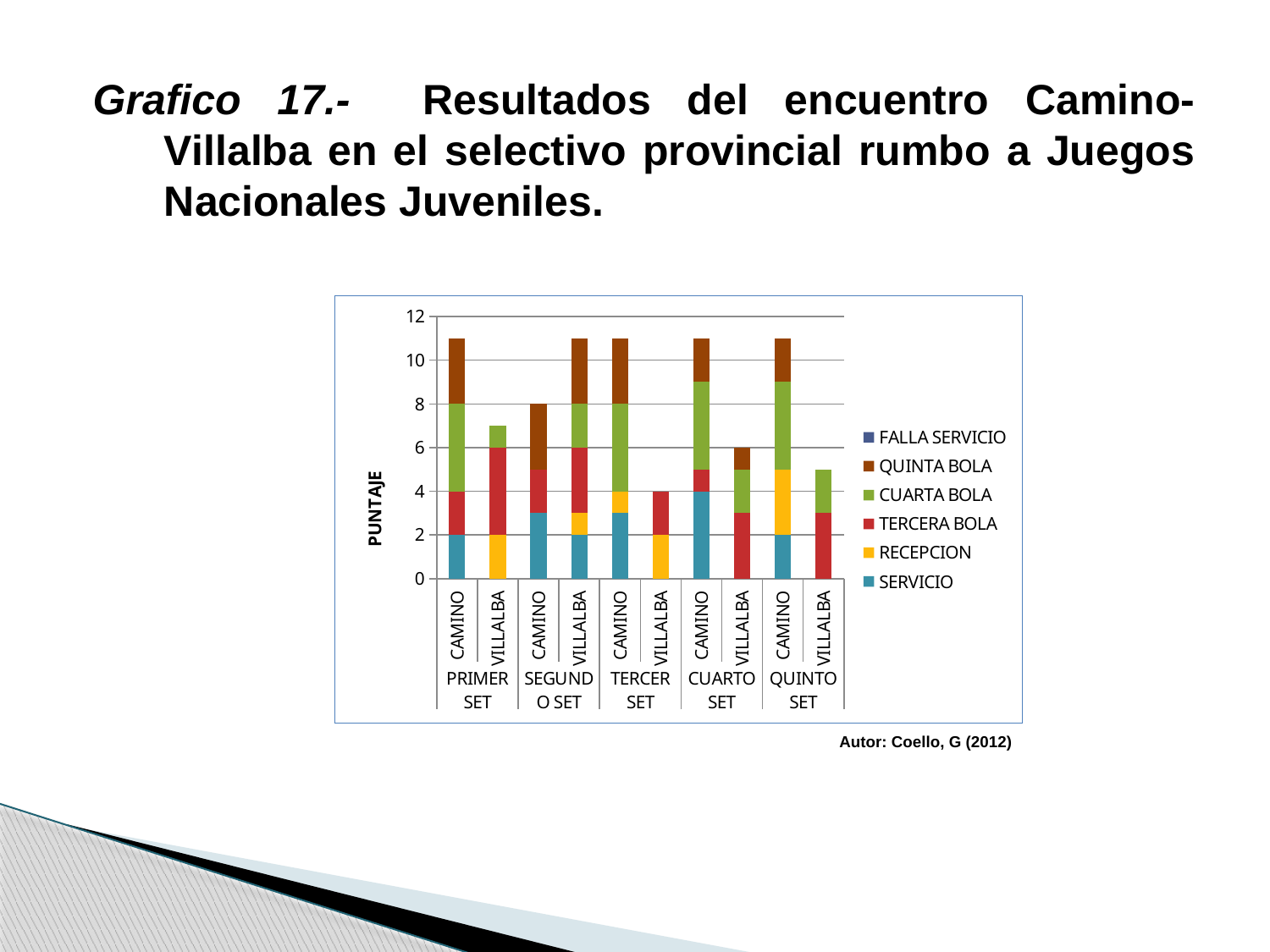
Which bar has the lowest total score in the chart? VILLALBA, TERCER SET Is the total for CAMINO in PRIMER SET greater or less than 10? greater What kind of chart is shown on the slide? Stacked bar chart What is the total height of the CAMINO bar in SEGUNDO SET? 8 In PRIMER SET, which team has the taller bar, CAMINO or VILLALBA? CAMINO What is the label of the y axis? PUNTAJE What is the SERVICIO value for CAMINO in CUARTO SET? 4 What is the total height of the VILLALBA bar in CUARTO SET? 6 How many bars are plotted in the chart? 10 How many series does the legend list? 6 How many sets are shown along the x axis? 5 What is the total height of the VILLALBA bar in TERCER SET? 4